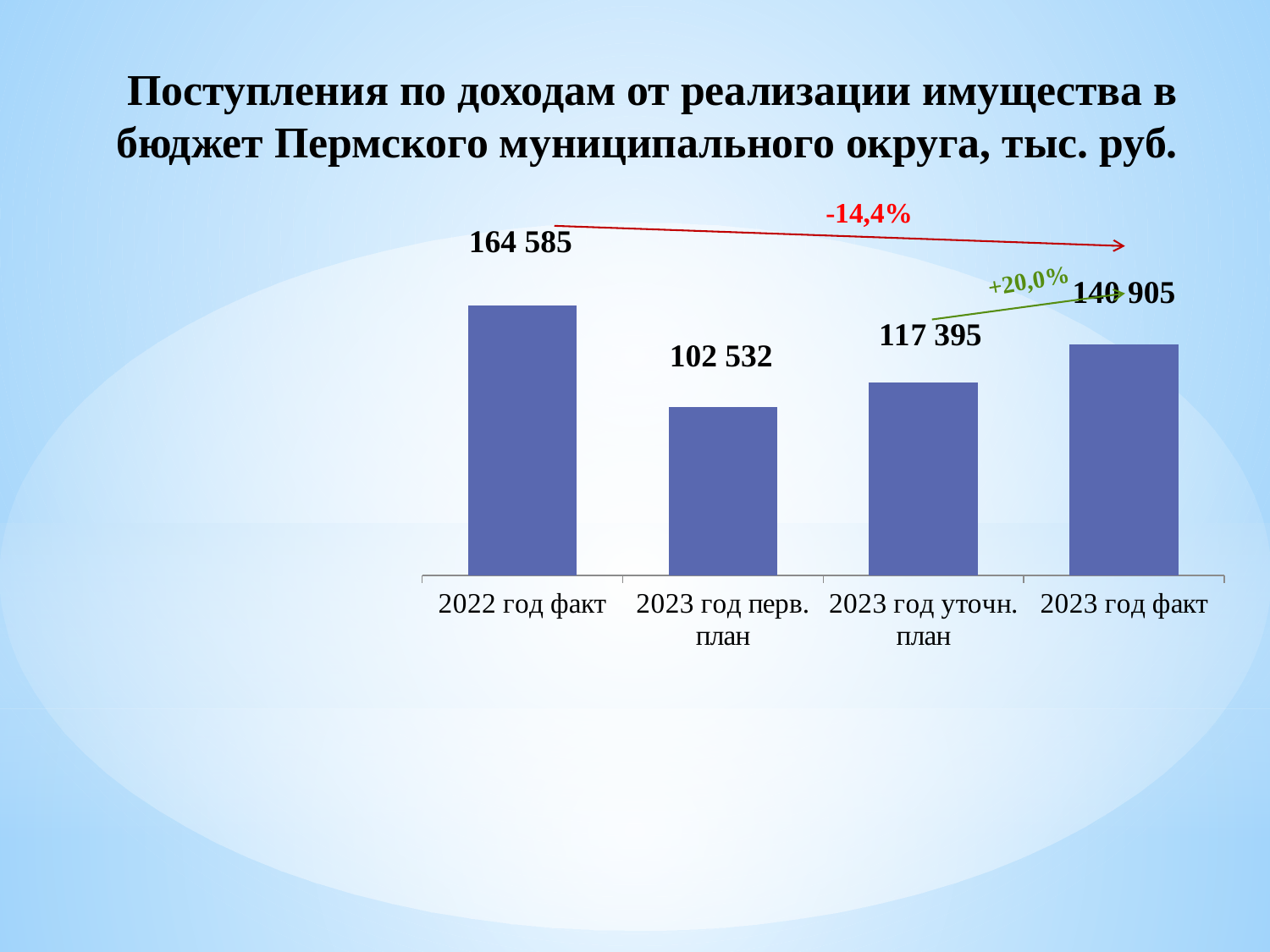
What is the difference between the values for "2023 год уточн. план" and "2023 год перв. план"? 14 863 What kind of chart is shown on the slide? Bar chart Which category has the lowest value? 2023 год перв. план Which is larger, the value for "2023 год уточн. план" or the value for "2023 год факт"? 2023 год факт What is the difference between the values for "2022 год факт" and "2023 год факт"? 23 680 Which category has the highest value? 2022 год факт What is the value for "2022 год факт"? 164 585 How many categories are shown in the chart? 4 What is the value for "2023 год факт"? 140 905 What is the value for "2023 год уточн. план"? 117 395 What percentage change is shown by the red arrow from "2022 год факт" to "2023 год факт"? -14,4% What is the value for "2023 год перв. план"? 102 532